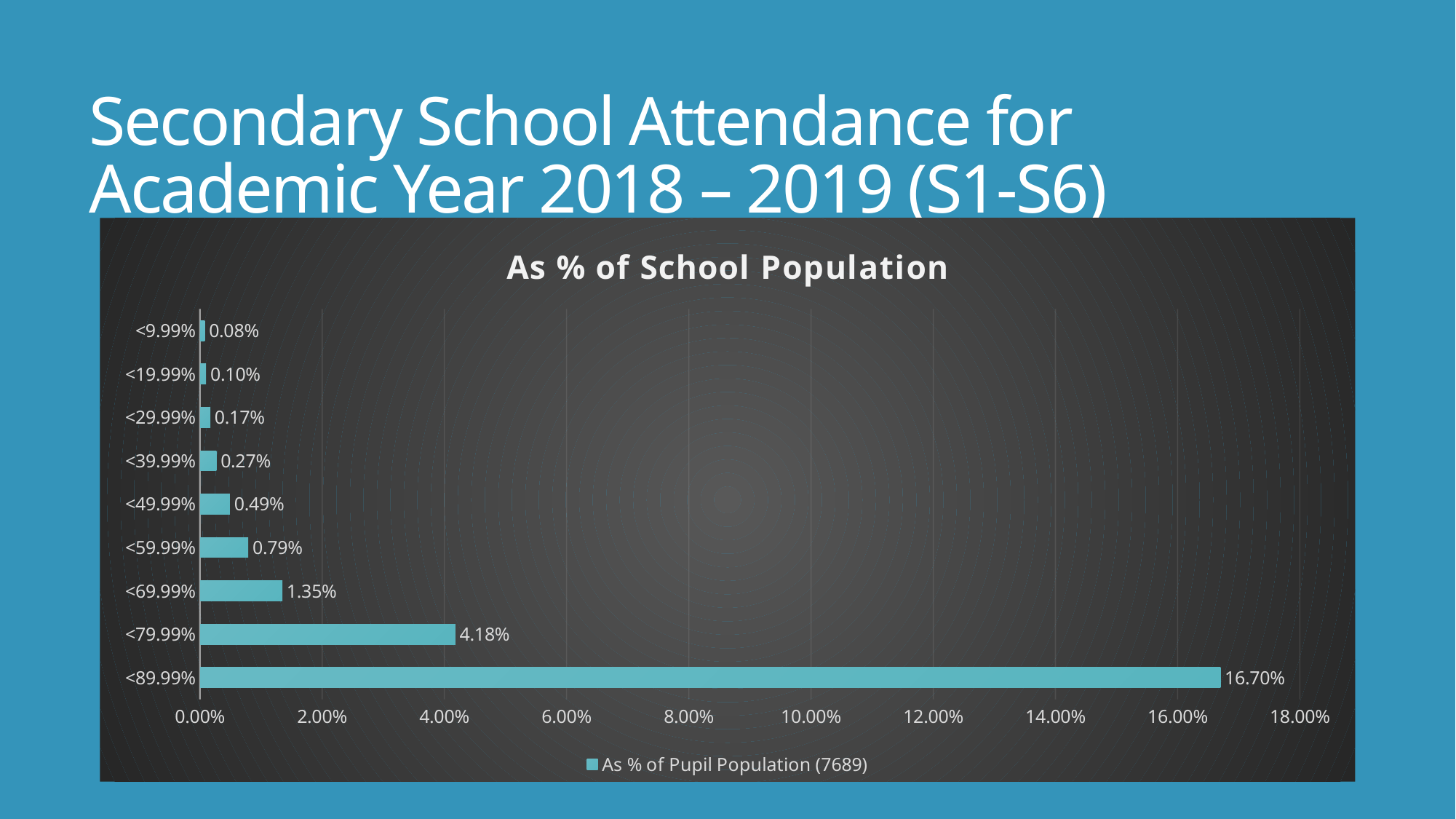
What is the difference between the values for <89.99% and <79.99%? 12.52% How many series does the legend list? 1 What is the title of the chart? As % of School Population What kind of chart is shown on the slide? Bar chart Which is larger, the value for <69.99% or the value for <59.99%? <69.99% What is the value for the <79.99% category? 4.18% Which category has the lowest value? <9.99% Is the value for <89.99% greater or less than 16.00%? greater What is the value for the <49.99% category? 0.49% Which category has the highest value? <89.99% What is the value for the <89.99% category? 16.70% How many categories are shown on the chart? 9